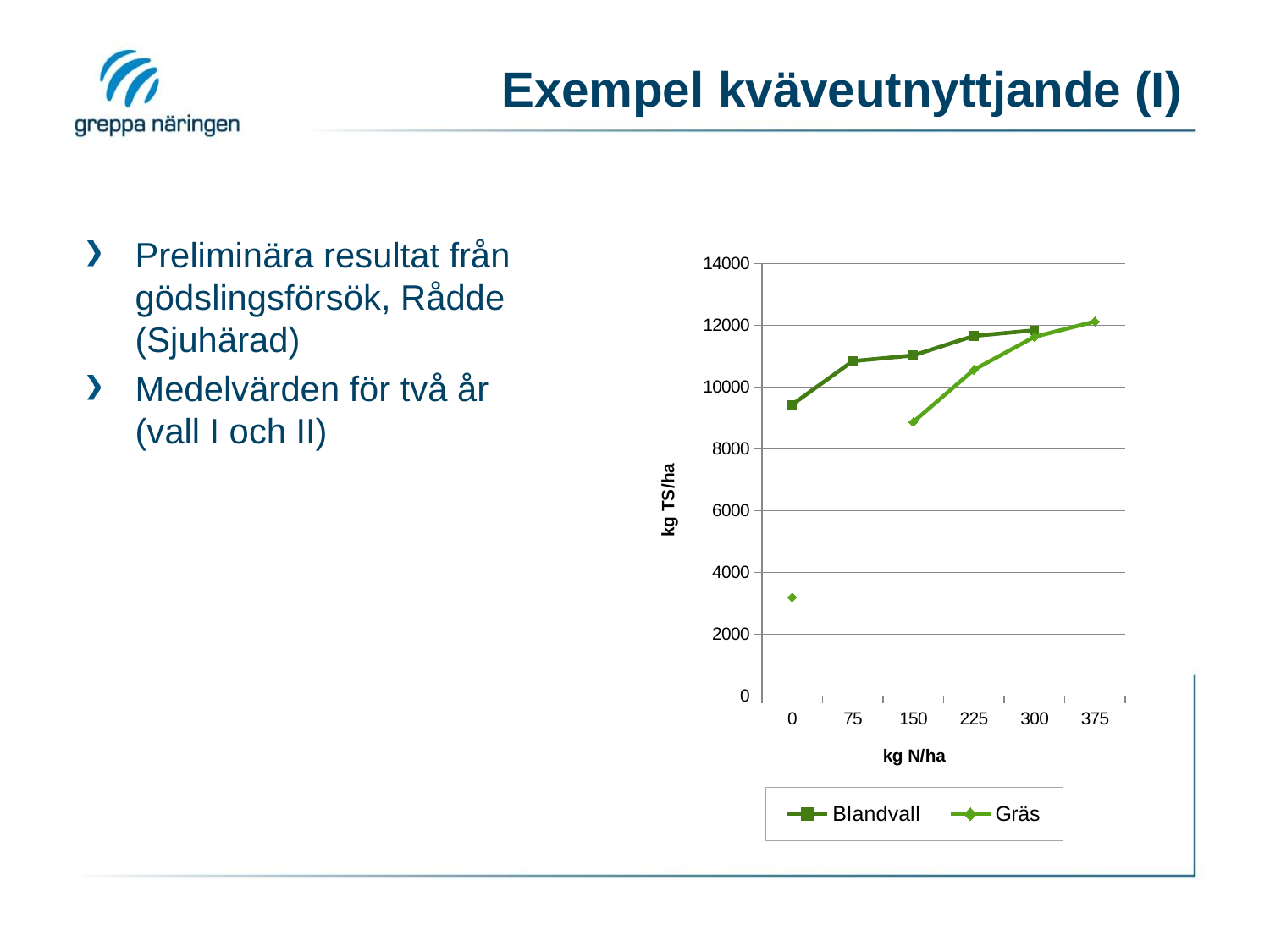
How many categories are shown on the x axis of the chart? 6 Do the values for Gräs rise or fall as kg N/ha increases? rise What kind of chart is shown on the slide? line chart Is the value for Gräs at 150 kg N/ha greater or less than 10000? less At 0 kg N/ha, which series has the larger value, Blandvall or Gräs? Blandvall Is the value for Gräs at 0 kg N/ha greater or less than 4000? less At 150 kg N/ha, which series has the larger value, Blandvall or Gräs? Blandvall Is the value for Gräs at 225 kg N/ha greater or less than 10000? greater What is the title of the y axis of the chart? kg TS/ha How many series does the chart legend list? 2